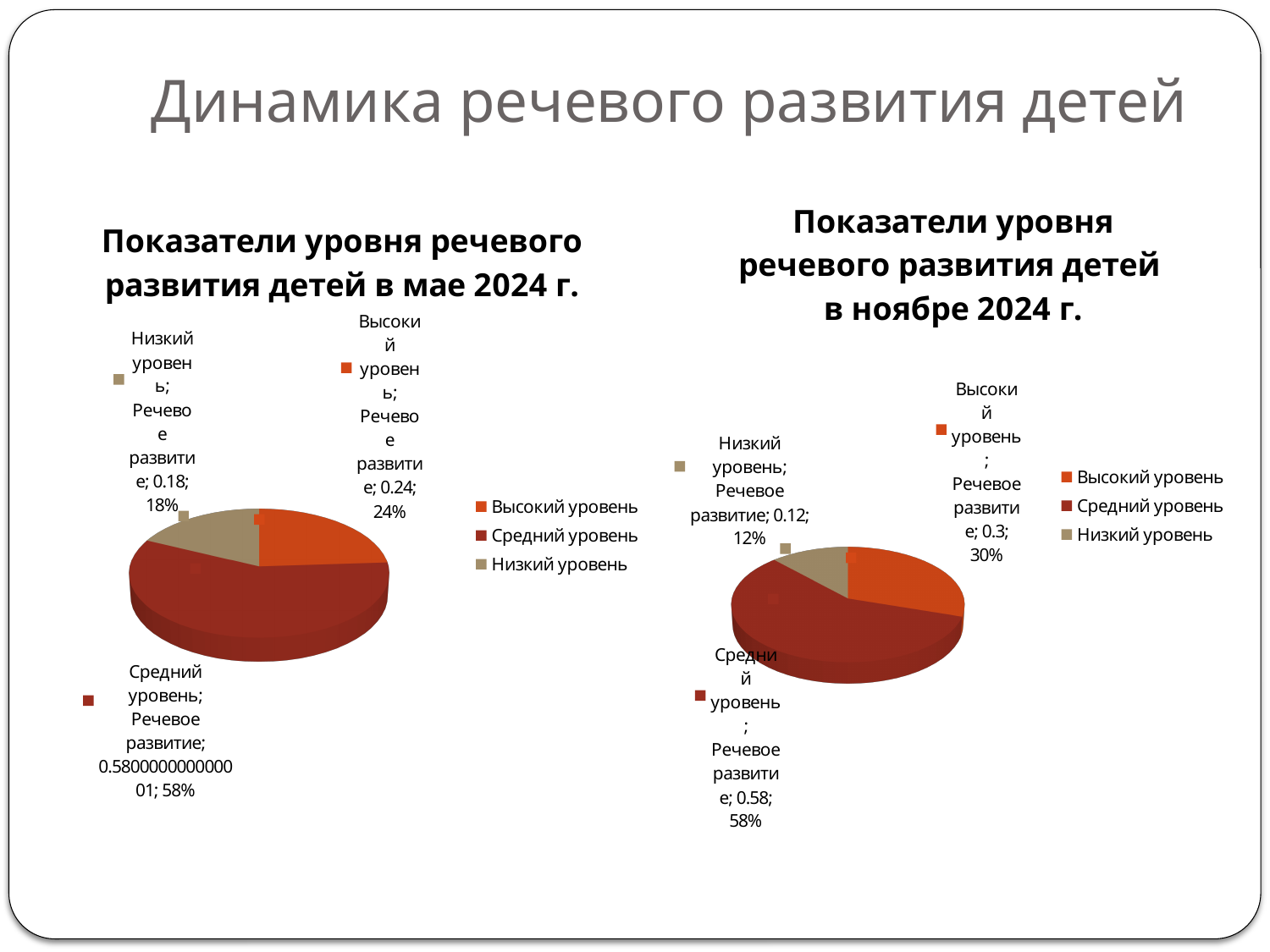
How many categories does the chart 'Показатели уровня речевого развития детей в мае 2024 г.' show? 3 In the chart 'Показатели уровня речевого развития детей в мае 2024 г.', what colour is the Низкий уровень slice? Beige (tan) In the chart 'Показатели уровня речевого развития детей в мае 2024 г.', what percentage is shown for Низкий уровень? 18% Comparing the two charts, is the share of Высокий уровень larger in May 2024 or in November 2024? November 2024 In the chart 'Показатели уровня речевого развития детей в ноябре 2024 г.', which category has the smallest share? Низкий уровень In the chart 'Показатели уровня речевого развития детей в ноябре 2024 г.', what percentage is shown for Высокий уровень? 30% In the chart 'Показатели уровня речевого развития детей в ноябре 2024 г.', what is the difference in percentage points between Высокий уровень and Низкий уровень? 18 In the chart 'Показатели уровня речевого развития детей в ноябре 2024 г.', what percentage is shown for Низкий уровень? 12% In the chart 'Показатели уровня речевого развития детей в мае 2024 г.', what is the difference in percentage points between Средний уровень and Высокий уровень? 34 In the chart 'Показатели уровня речевого развития детей в мае 2024 г.', which category has the largest share? Средний уровень What type of chart is 'Показатели уровня речевого развития детей в ноябре 2024 г.'? Pie chart In the chart 'Показатели уровня речевого развития детей в мае 2024 г.', what percentage is shown for Высокий уровень? 24%